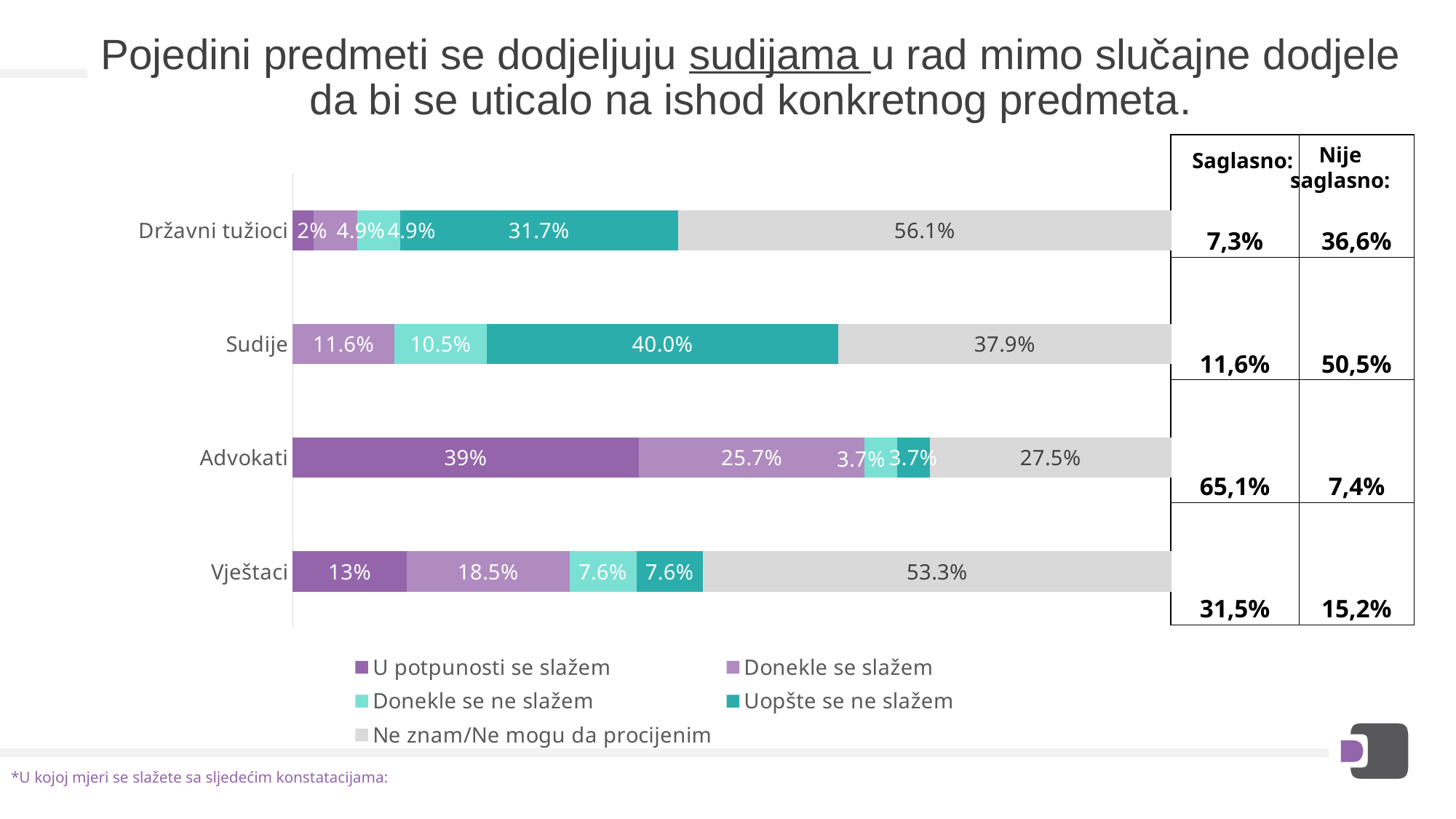
Which has a larger "Uopšte se ne slažem" value, Sudije or Državni tužioci? Sudije What colour represents "Ne znam/Ne mogu da procijenim" in the legend? Grey What kind of chart is shown on the slide? Stacked bar chart What is the value of "Ne znam/Ne mogu da procijenim" for Državni tužioci? 56.1% Which category has the lowest value for "Ne znam/Ne mogu da procijenim"? Advokati What is the difference between the "Ne znam/Ne mogu da procijenim" values for Državni tužioci and Vještaci? 2.8 percentage points What is the value of "Uopšte se ne slažem" for Sudije? 40.0% How many categories are shown on the chart? 4 How many series does the legend list? 5 Which category has the highest value for "U potpunosti se slažem"? Advokati What is the value of "U potpunosti se slažem" for Advokati? 39% What is the value of "Donekle se slažem" for Vještaci? 18.5%